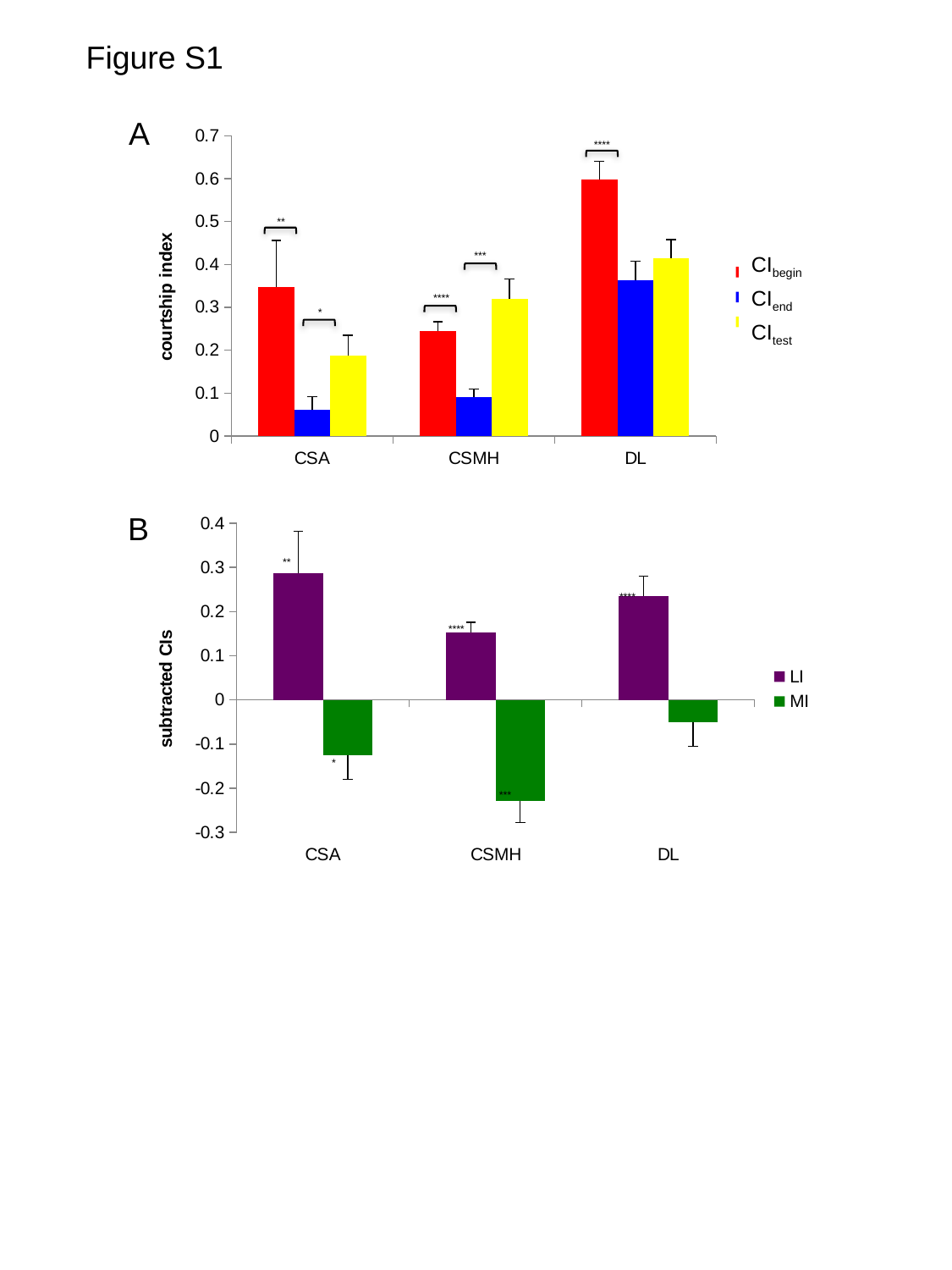
In chart B (subtracted CIs), is the LI value for CSA greater or less than 0.2? greater In chart A (courtship index), how many categories are shown on the x axis? 3 In chart B (subtracted CIs), which category has the lowest MI value? CSMH In chart A (courtship index), which category has the highest CI_begin value? DL In chart A (courtship index), is the CI_end value for CSA greater or less than 0.1? less In chart A (courtship index), how many series does the legend list? 3 In chart B (subtracted CIs), which category has the highest LI value? CSA What is the y-axis label of chart A? courtship index In chart A (courtship index), is the CI_begin value for DL greater or less than 0.5? greater What kind of chart is chart A (courtship index)? bar chart In chart B (subtracted CIs), how many series does the legend list? 2 In chart A (courtship index), for CSMH, which is larger: CI_begin or CI_test? CI_test